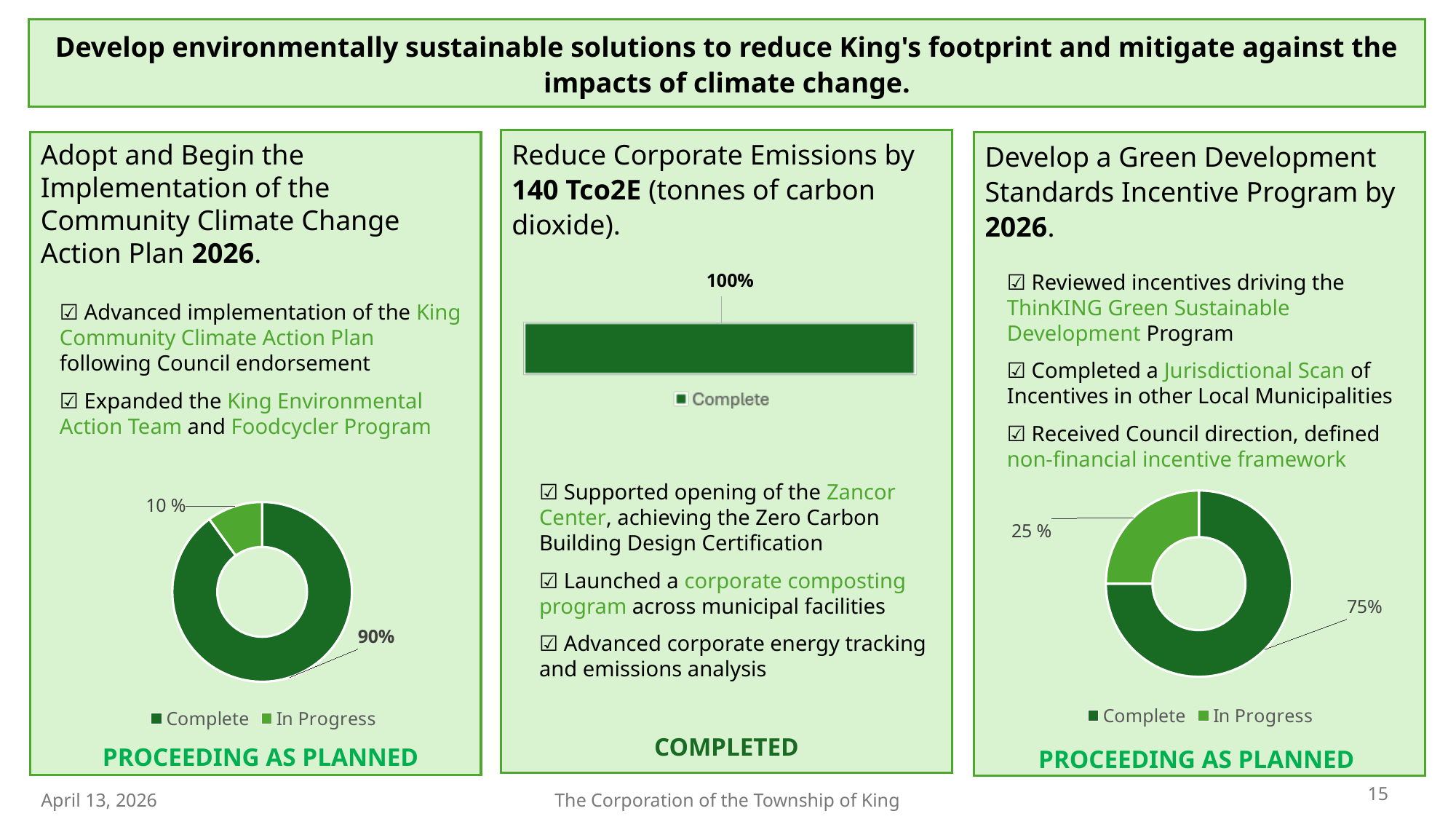
What kind of chart is shown in the left panel? Doughnut chart In the doughnut chart in the right panel, which slice is the smallest? In Progress In the doughnut chart in the right panel, what is the difference between the Complete and In Progress values? 50% In the doughnut chart in the left panel, which slice is larger, Complete or In Progress? Complete In the doughnut chart in the right panel, what is the value for In Progress? 25 % In the doughnut chart in the right panel, what is the value for Complete? 75% In the bar chart in the middle panel, how many bars are plotted? 1 In the bar chart in the middle panel, what is the value for Complete? 100% In the doughnut chart in the left panel, what is the value for In Progress? 10 % In the doughnut chart in the left panel, what is the value for Complete? 90% In the doughnut chart in the left panel, how many series does the legend list? 2 What kind of chart is shown in the middle panel? Bar chart